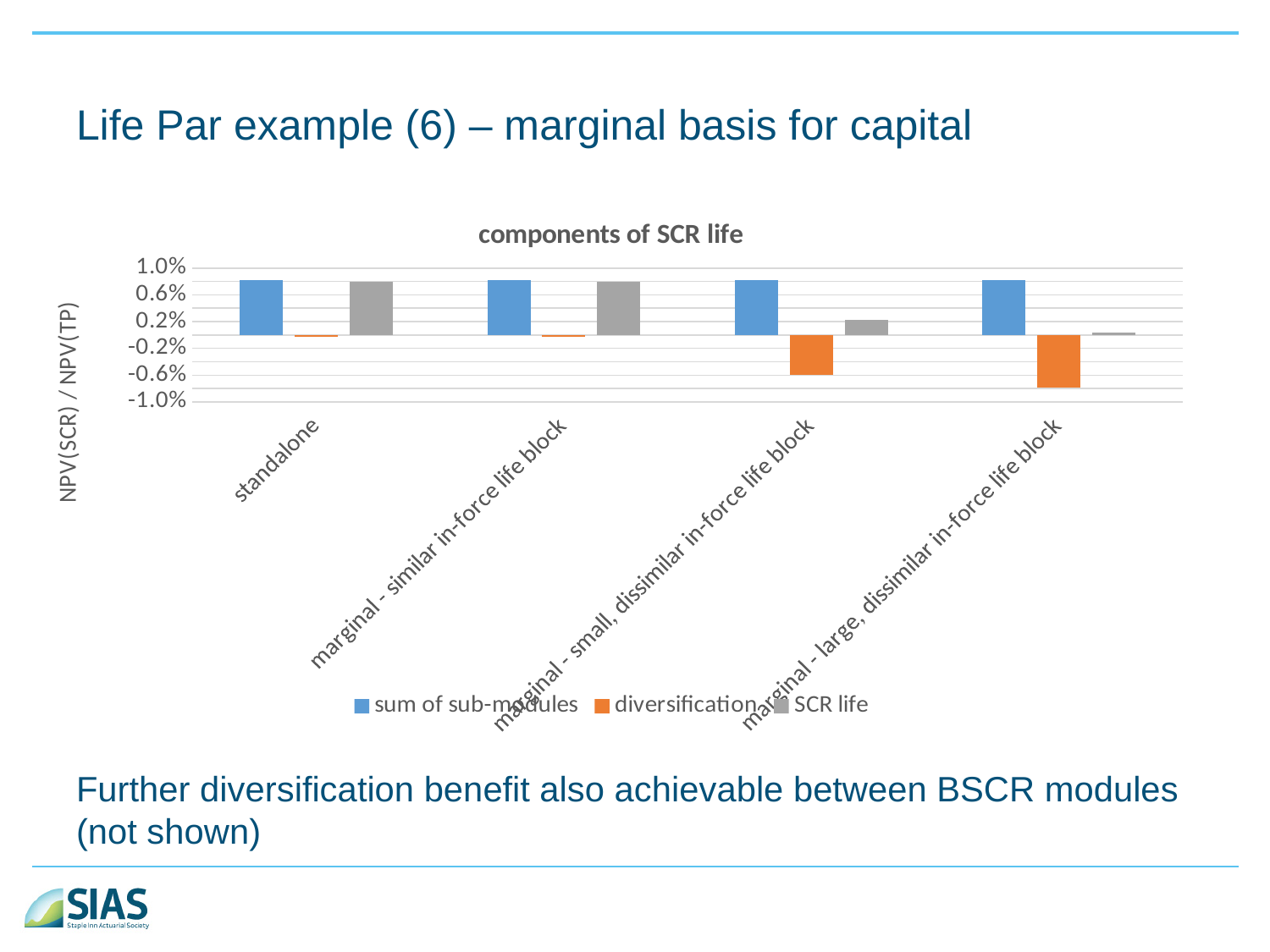
Which is larger: the 'SCR life' value for 'standalone' or for 'marginal - large, dissimilar in-force life block'? standalone How many categories are shown on the x axis of the chart? 4 What is the title of the chart? components of SCR life Is the value of 'SCR life' for 'marginal - large, dissimilar in-force life block' greater or less than 0.2%? less What is the label on the vertical axis of the chart? NPV(SCR) / NPV(TP) Which category has the lowest value for the 'diversification' series? marginal - large, dissimilar in-force life block Is the value of 'SCR life' for 'marginal - small, dissimilar in-force life block' greater or less than 0.6%? less Is the value of 'diversification' for 'marginal - large, dissimilar in-force life block' greater or less than -0.6%? less How many series does the chart's legend list? 3 Do the 'SCR life' values rise or fall moving from left to right across the categories? fall What kind of chart is shown on the slide? bar chart